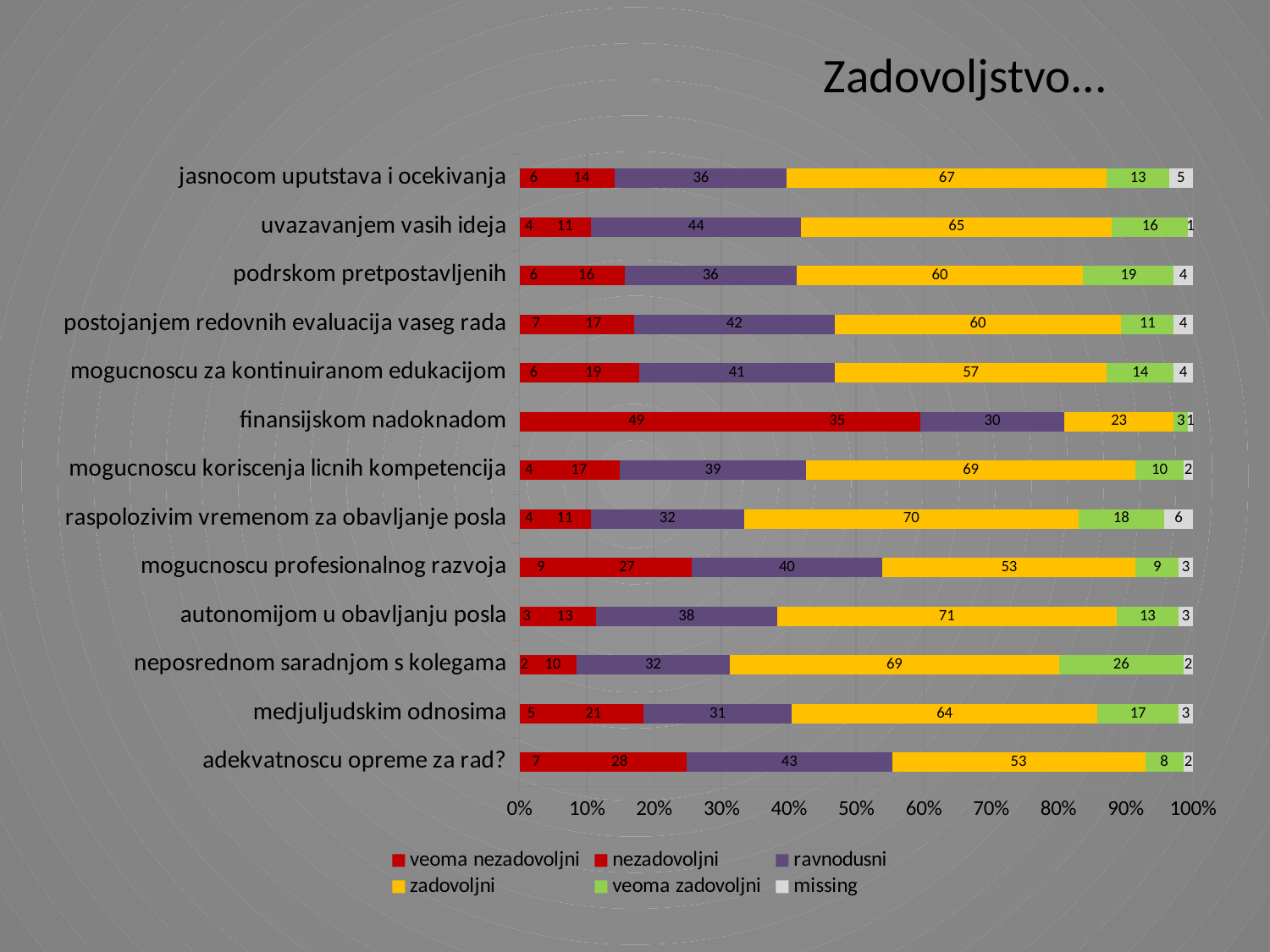
How many series does the legend list? 6 Which has the larger 'veoma zadovoljni' value: 'podrskom pretpostavljenih' or 'postojanjem redovnih evaluacija vaseg rada'? podrskom pretpostavljenih What is the title of the chart? Zadovoljstvo… What is the difference between the 'zadovoljni' values for 'autonomijom u obavljanju posla' and 'finansijskom nadoknadom'? 48 How many categories are plotted on the chart? 13 What is the 'ravnodusni' value for 'adekvatnoscu opreme za rad?'? 43 What is the 'zadovoljni' value for 'autonomijom u obavljanju posla'? 71 What is the 'veoma nezadovoljni' value for 'finansijskom nadoknadom'? 49 What is the total of all segments in the bar for 'jasnocom uputstava i ocekivanja'? 141 Which category has the highest 'veoma zadovoljni' value? neposrednom saradnjom s kolegama Which category has the lowest 'zadovoljni' value? finansijskom nadoknadom What kind of chart is shown on the slide? stacked bar chart